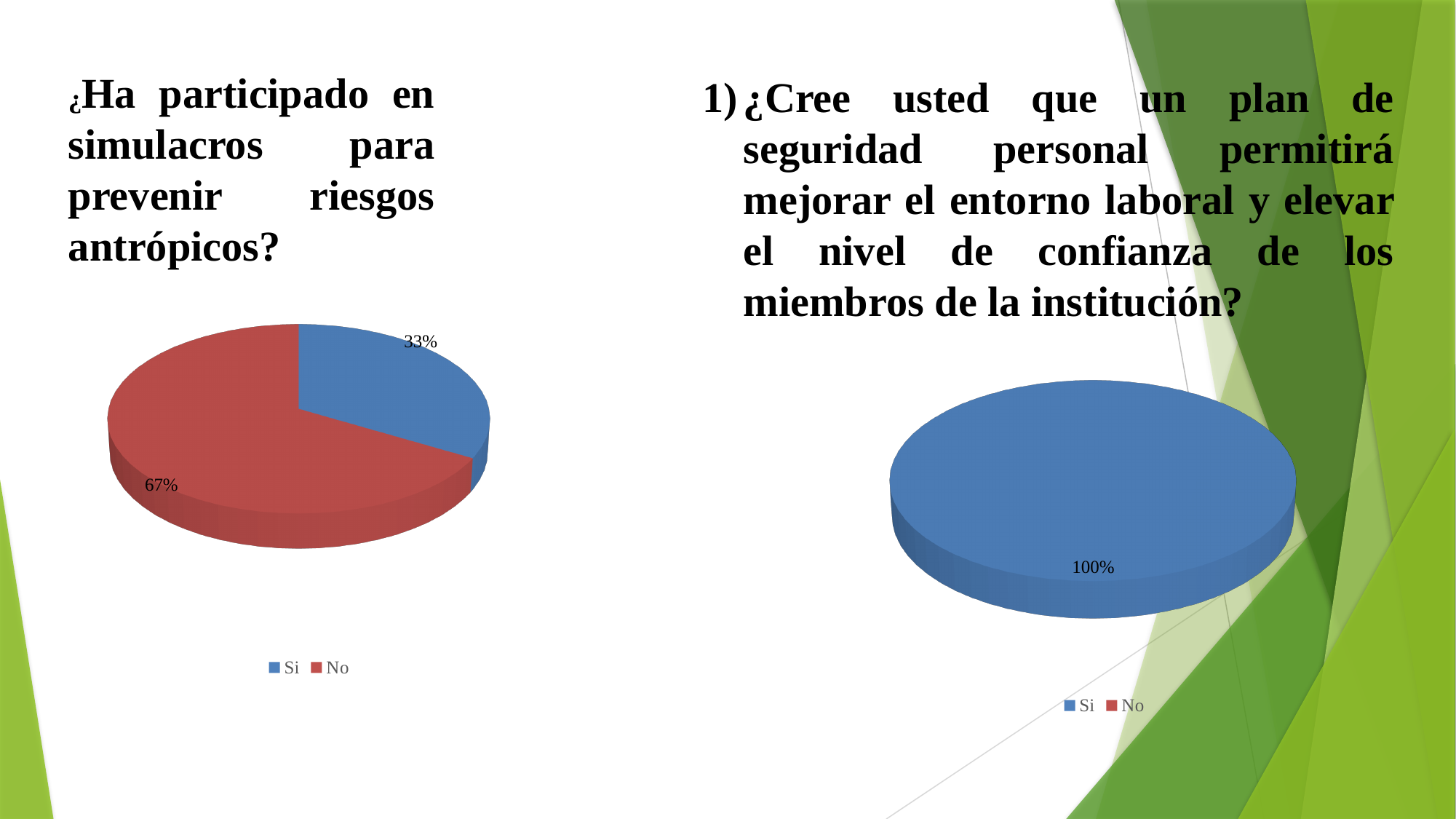
What type of chart is the left chart (simulacros para prevenir riesgos antrópicos)? Pie chart In the left pie chart (simulacros para prevenir riesgos antrópicos), what colour is the 'No' slice? Red In the left pie chart (simulacros para prevenir riesgos antrópicos), which is larger, 'Si' or 'No'? No In the left pie chart (simulacros para prevenir riesgos antrópicos), what is the difference in percentage points between 'No' and 'Si'? 34 In the left pie chart (simulacros para prevenir riesgos antrópicos), what share is labelled for 'No'? 67% How many pie charts are shown on the slide? 2 In the left pie chart (simulacros para prevenir riesgos antrópicos), which category has the largest slice? No In the left pie chart (simulacros para prevenir riesgos antrópicos), which category has the smallest slice? Si In the left pie chart (simulacros para prevenir riesgos antrópicos), what share is labelled for 'Si'? 33% In the right pie chart (plan de seguridad personal), which category accounts for the entire pie? Si How many entries does the legend of the right pie chart (plan de seguridad personal) list? 2 In the right pie chart (plan de seguridad personal), what share is labelled on the pie? 100%